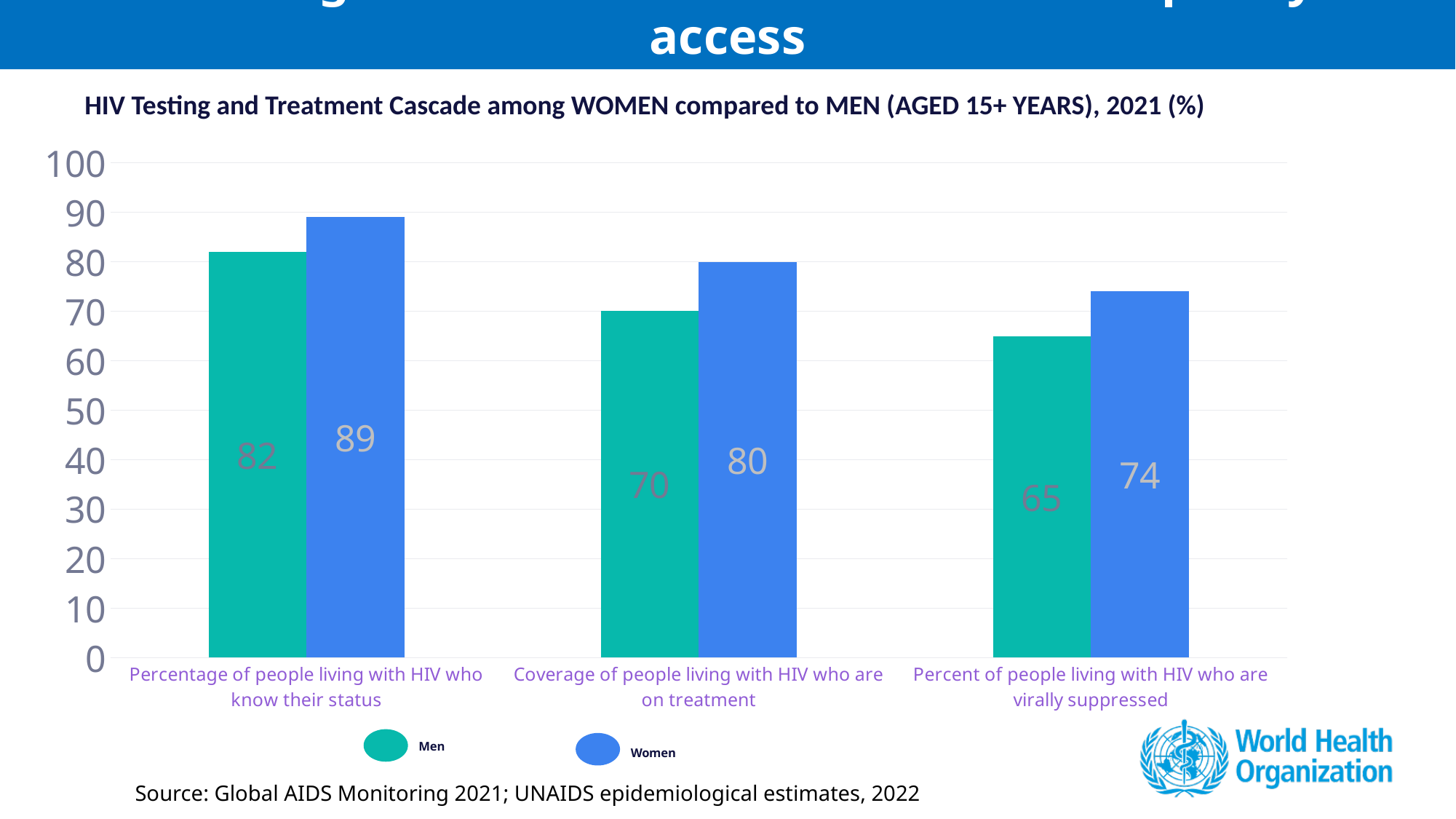
Do the values for Men rise or fall across the categories from left to right? Fall Which category has the lowest value for Men? Percent of people living with HIV who are virally suppressed What kind of chart is shown on the slide? Bar chart What is the difference between the Women and Men values in the 'Coverage of people living with HIV who are on treatment' category? 10 What is the value for Men in the 'Percentage of people living with HIV who know their status' category? 82 Which category has the highest value for Women? Percentage of people living with HIV who know their status How many series does the legend list? 2 What is the value for Men in the 'Percent of people living with HIV who are virally suppressed' category? 65 Is the value for Women in the 'Percentage of people living with HIV who know their status' category greater or less than 80? greater How many categories are shown on the x axis? 3 What is the value for Women in the 'Coverage of people living with HIV who are on treatment' category? 80 In the 'Percent of people living with HIV who are virally suppressed' category, which is larger, the value for Men or for Women? Women